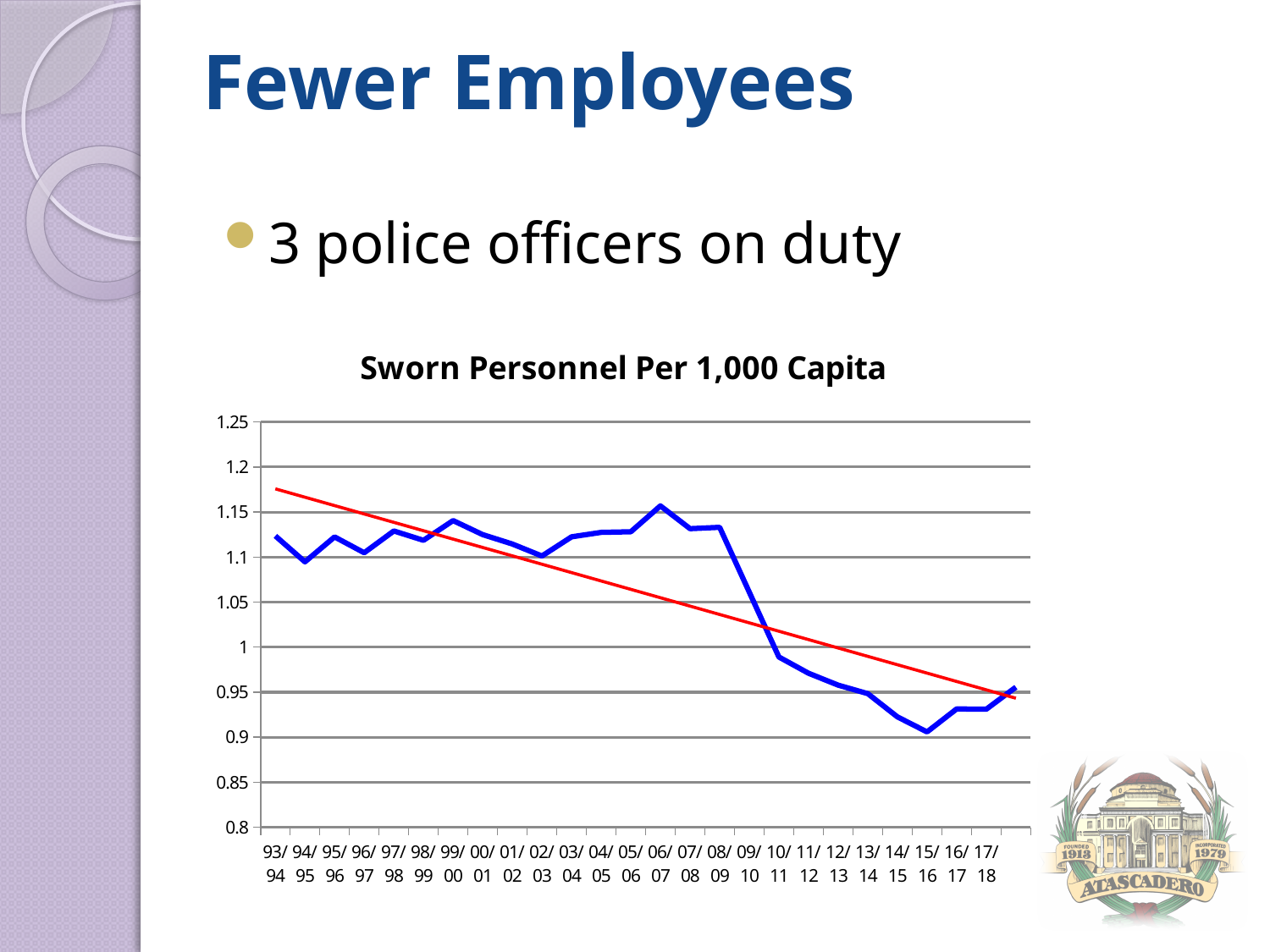
Is the value for 09/10 greater or less than 1.1? less Which fiscal year has the highest value in the chart? 06/07 Which has the larger value, 06/07 or 15/16? 06/07 How many fiscal years are plotted along the x axis of the chart? 25 What kind of chart is shown on the slide? line chart Is the value for 12/13 greater or less than 1? less Which fiscal year has the lowest value in the chart? 15/16 What colour is the straight trend line drawn across the chart? red Overall, do the values in the chart rise or fall from 93/94 to 17/18? fall Is the value for 15/16 greater or less than 0.95? less What is the title of the chart? Sworn Personnel Per 1,000 Capita